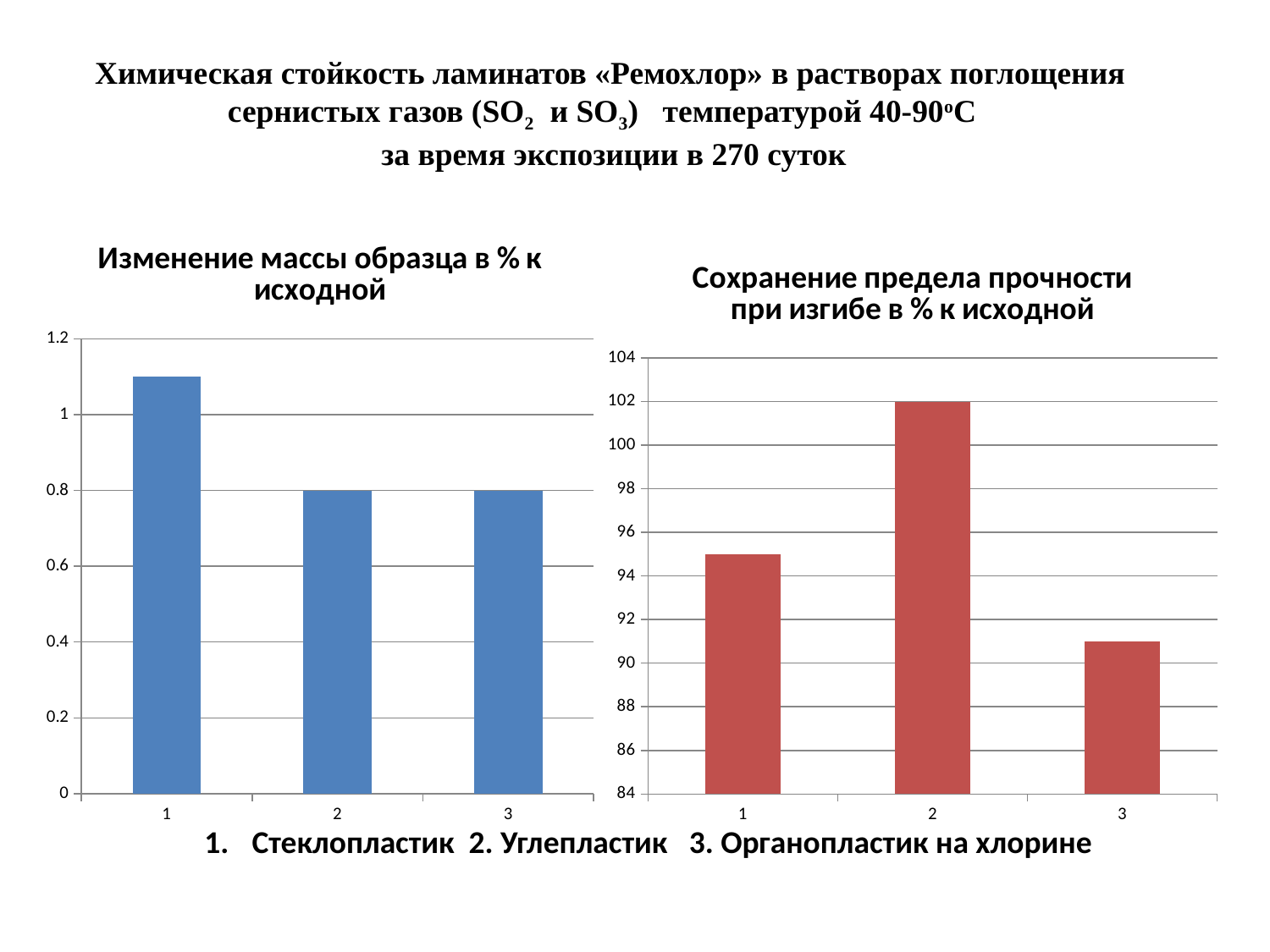
In the chart titled «Изменение массы образца в % к исходной», is the value for category 1 greater or less than 1? greater What kind of chart is the left chart on the slide? bar chart In the chart titled «Сохранение предела прочности при изгибе в % к исходной», which category has the highest value? 2 In the chart titled «Сохранение предела прочности при изгибе в % к исходной», which category has the lowest value? 3 In the chart titled «Сохранение предела прочности при изгибе в % к исходной», is the value for category 1 greater or less than 94? greater In the chart titled «Сохранение предела прочности при изгибе в % к исходной», is the value for category 3 greater or less than 92? less In the chart titled «Изменение массы образца в % к исходной», what is the value for category 2? 0.8 In the chart titled «Изменение массы образца в % к исходной», which category has the highest value? 1 In the chart titled «Сохранение предела прочности при изгибе в % к исходной», what is the value for category 2? 102 In the chart titled «Изменение массы образца в % к исходной», what is the value for category 3? 0.8 In the chart titled «Сохранение предела прочности при изгибе в % к исходной», which is larger, the value for category 1 or category 3? 1 In the chart titled «Изменение массы образца в % к исходной», how many categories are plotted? 3